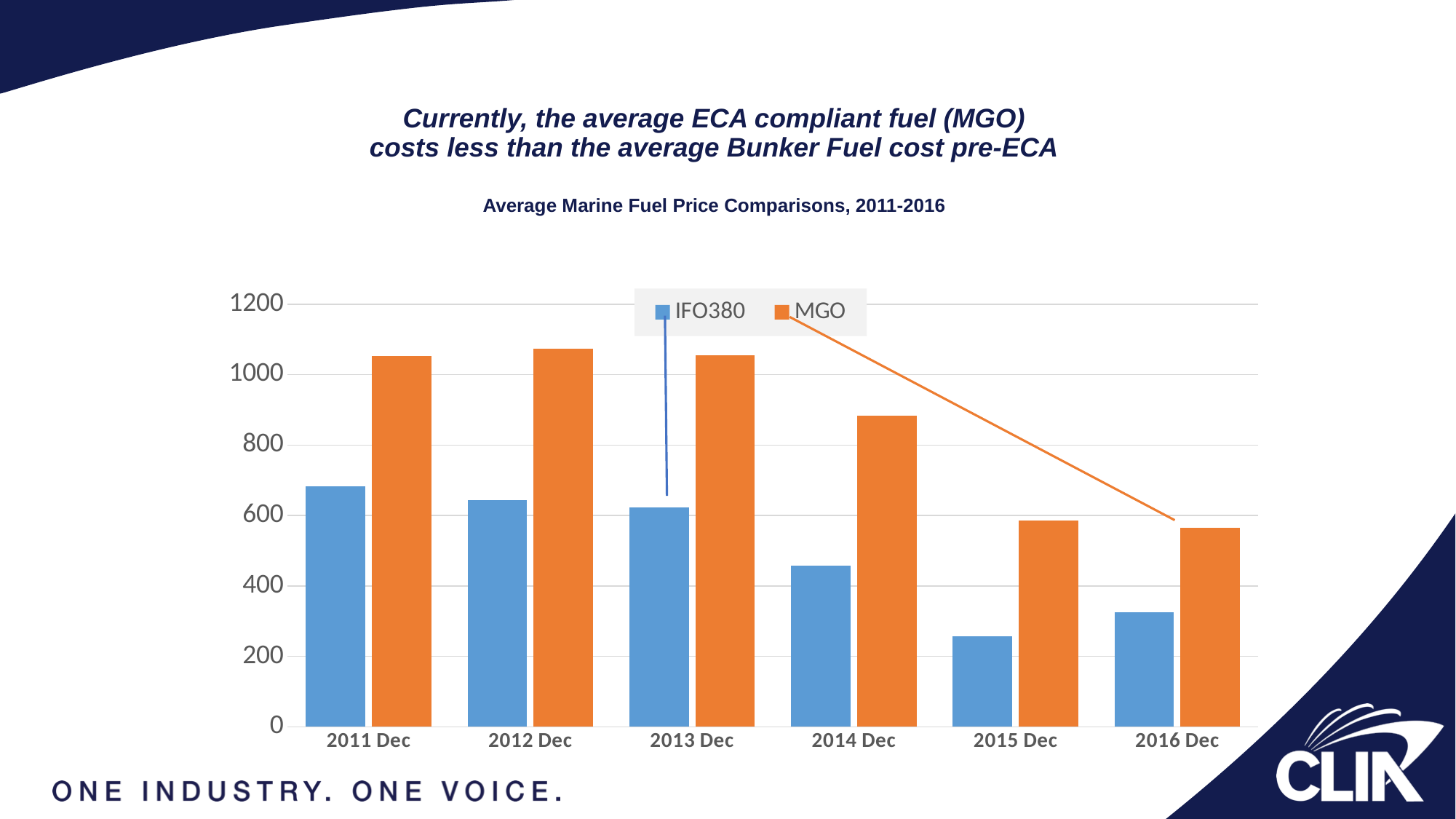
Is the MGO value for 2016 Dec greater or less than 600? less How many time periods are shown on the x axis? 6 Is the MGO value for 2014 Dec greater or less than 800? greater What kind of chart is shown on the slide? bar chart How many series does the legend list? 2 Does the MGO value rise or fall overall from 2011 Dec to 2016 Dec? fall Is the IFO380 value for 2015 Dec greater or less than 400? less Which period has the lowest IFO380 value? 2015 Dec In 2016 Dec, which series has the larger value, IFO380 or MGO? MGO Which period has the highest IFO380 value? 2011 Dec What is the title of the chart? Average Marine Fuel Price Comparisons, 2011-2016